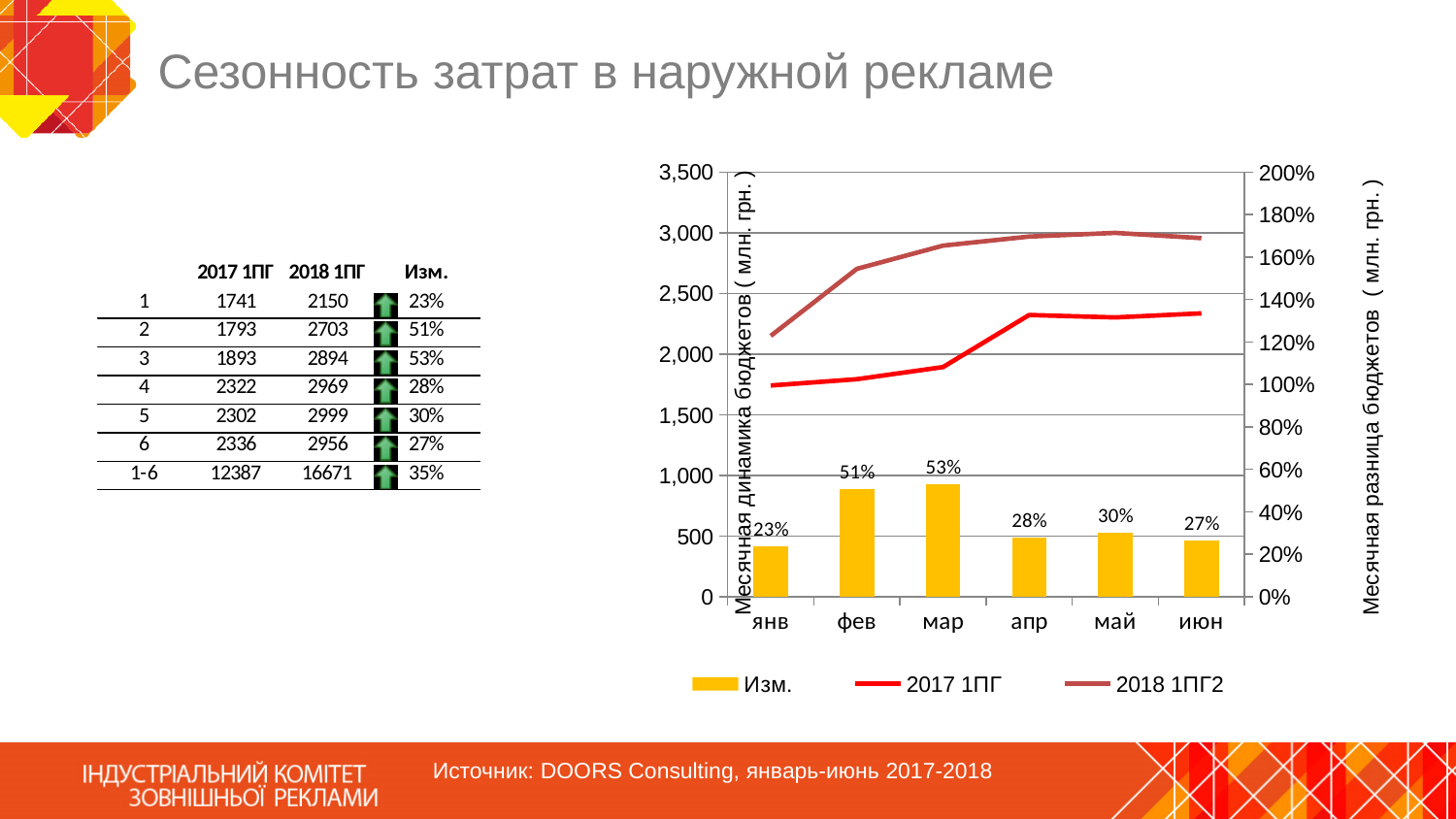
Which month has the lowest Изм. bar? янв How many series does the chart legend list? 3 How many months are shown on the x axis of the chart? 6 What kind of chart is shown on the slide? Combination bar and line chart Is the value of the 2018 1ПГ2 line for янв greater or less than 2,000? greater What is the value of the Изм. bar for май? 30% What is the value of the Изм. bar for фев? 51% Which is larger, the Изм. value for апр or for июн? апр Is the value of the 2017 1ПГ line for мар greater or less than 2,000? less Which month has the highest Изм. bar? мар Does the 2018 1ПГ2 line rise or fall from янв to мар? rise What is the difference between the Изм. values for мар and янв? 30 percentage points